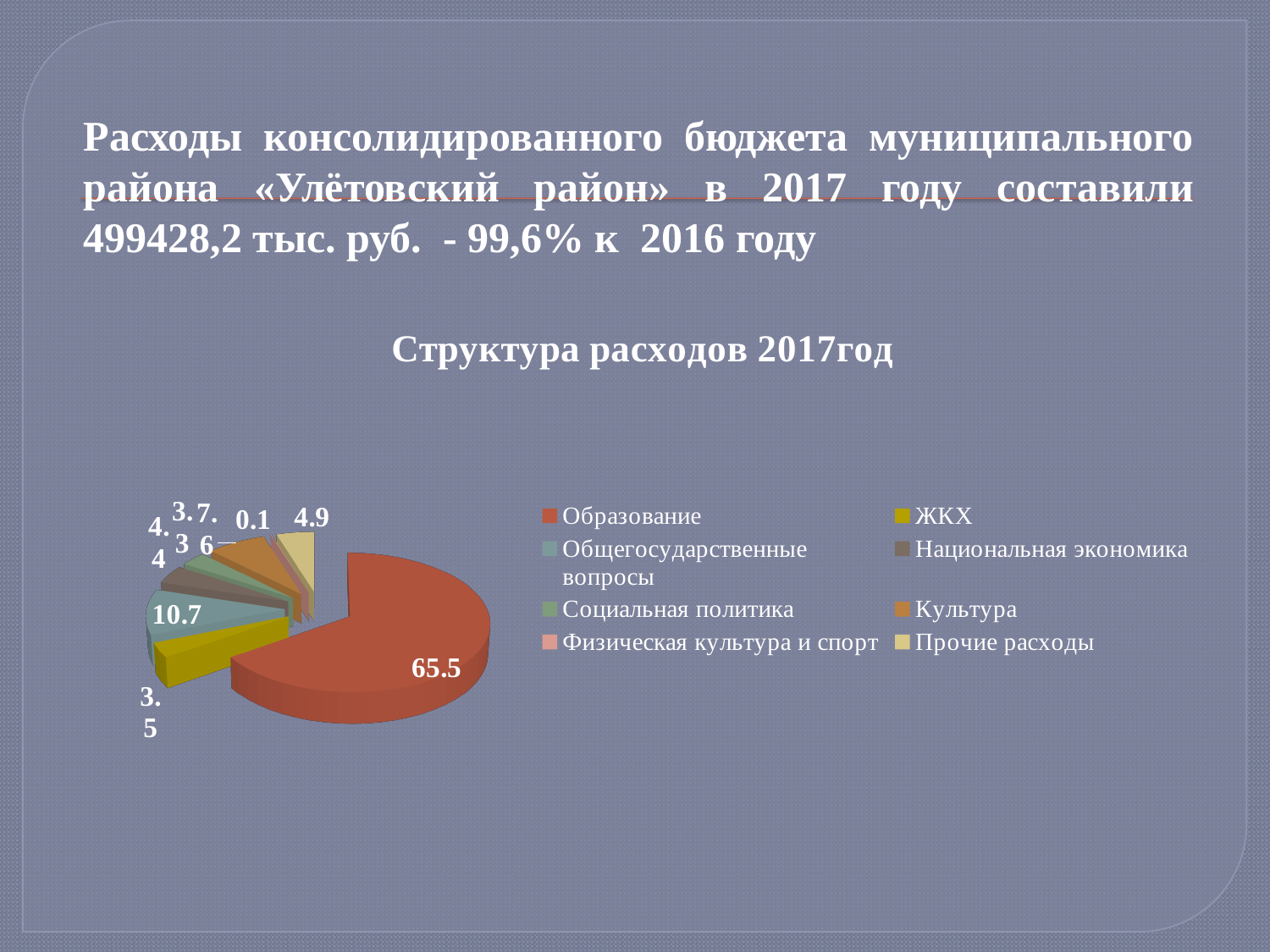
How many categories does the legend of the pie chart list? 8 Which category has the largest slice in the pie chart? Образование What is the value shown for Общегосударственные вопросы in the pie chart? 10.7 What type of chart is shown on the slide? pie chart What is the title of the pie chart? Структура расходов 2017год What is the difference between the values for Образование and Общегосударственные вопросы? 54.8 What is the value shown for Физическая культура и спорт in the pie chart? 0.1 Which is larger in the pie chart, Образование or Общегосударственные вопросы? Образование What colour is the Образование slice in the pie chart? red What is the value shown for Образование in the pie chart? 65.5 What is the value shown for Прочие расходы in the pie chart? 4.9 Which category has the smallest slice in the pie chart? Физическая культура и спорт